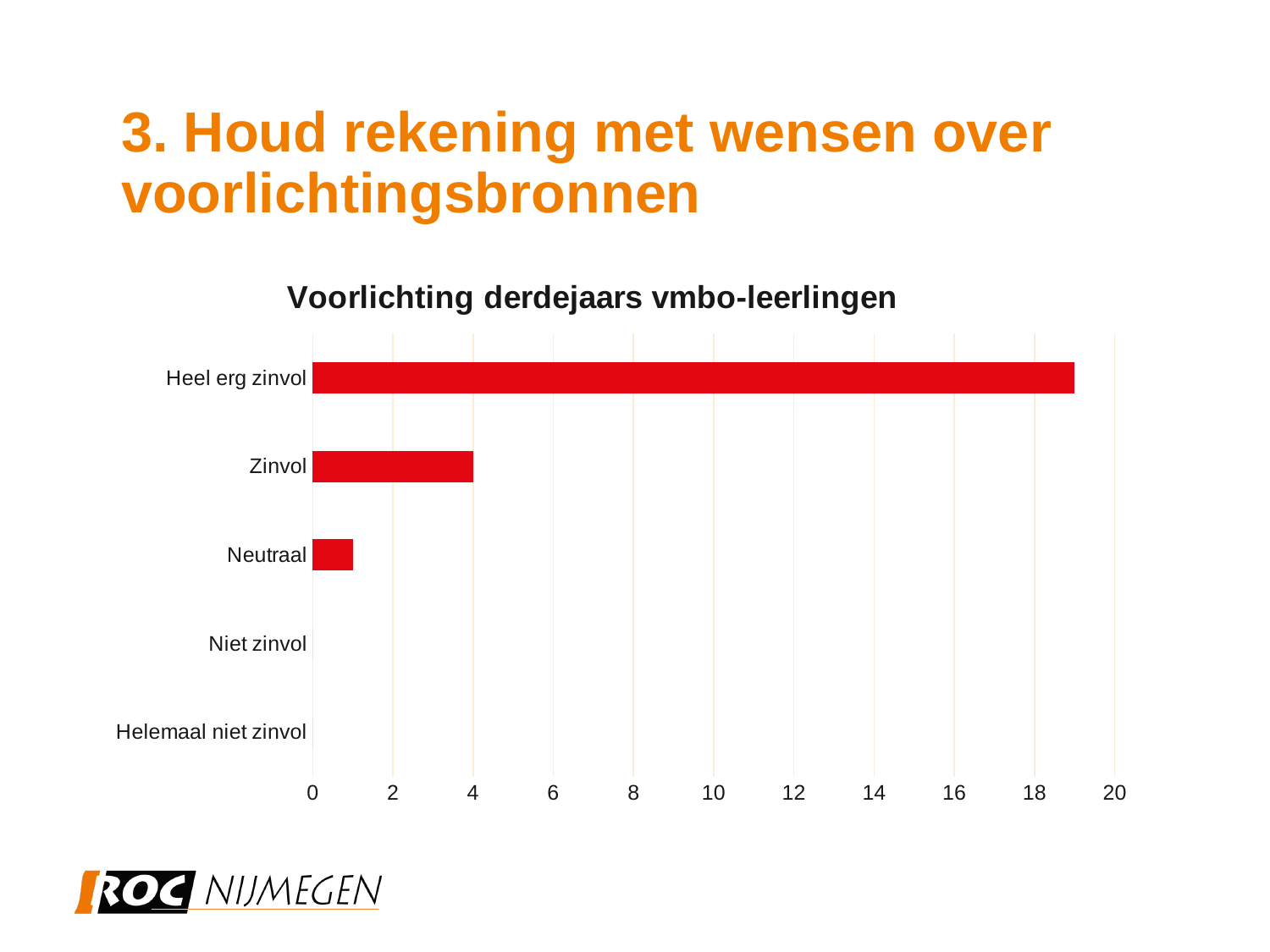
Is the value for Heel erg zinvol greater or less than 18? greater What kind of chart is shown on the slide? bar chart Is the value for Neutraal greater or less than 2? less What is the title of the chart? Voorlichting derdejaars vmbo-leerlingen What colour are the bars in the chart? red Which is larger, the value for Zinvol or the value for Neutraal? Zinvol Is the value for Heel erg zinvol greater or less than 20? less What is the value for Zinvol? 4 How many categories are shown on the chart? 5 How many categories have no visible bar? 2 Which is larger, the value for Heel erg zinvol or the value for Zinvol? Heel erg zinvol Which category has the highest value? Heel erg zinvol